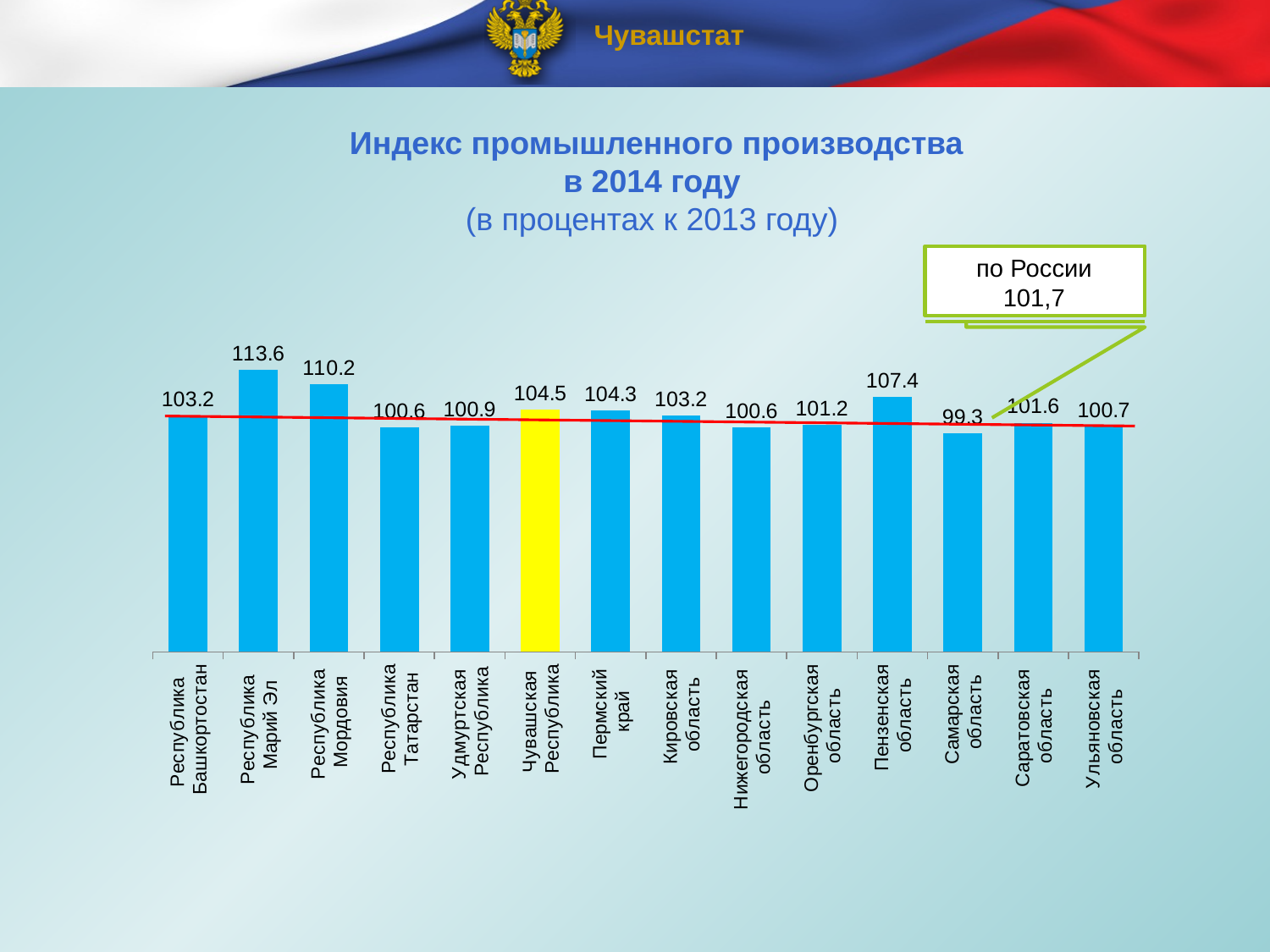
What value for Russia as a whole (по России) is shown in the callout box? 101,7 How many regions are shown on the chart? 14 Which region has the highest industrial production index on the chart? Республика Марий Эл Which is larger, the value for Пермский край or the value for Кировская область? Пермский край What is the value shown for Самарская область? 99.3 What type of chart is shown on the slide? Bar chart What is the difference between the values for Республика Марий Эл and Республика Мордовия? 3.4 What is the value shown for Пензенская область? 107.4 What is the difference between the values for Чувашская Республика and Самарская область? 5.2 Which region has the lowest industrial production index on the chart? Самарская область What is the value shown for Чувашская Республика? 104.5 What is the industrial production index value for Республика Марий Эл? 113.6